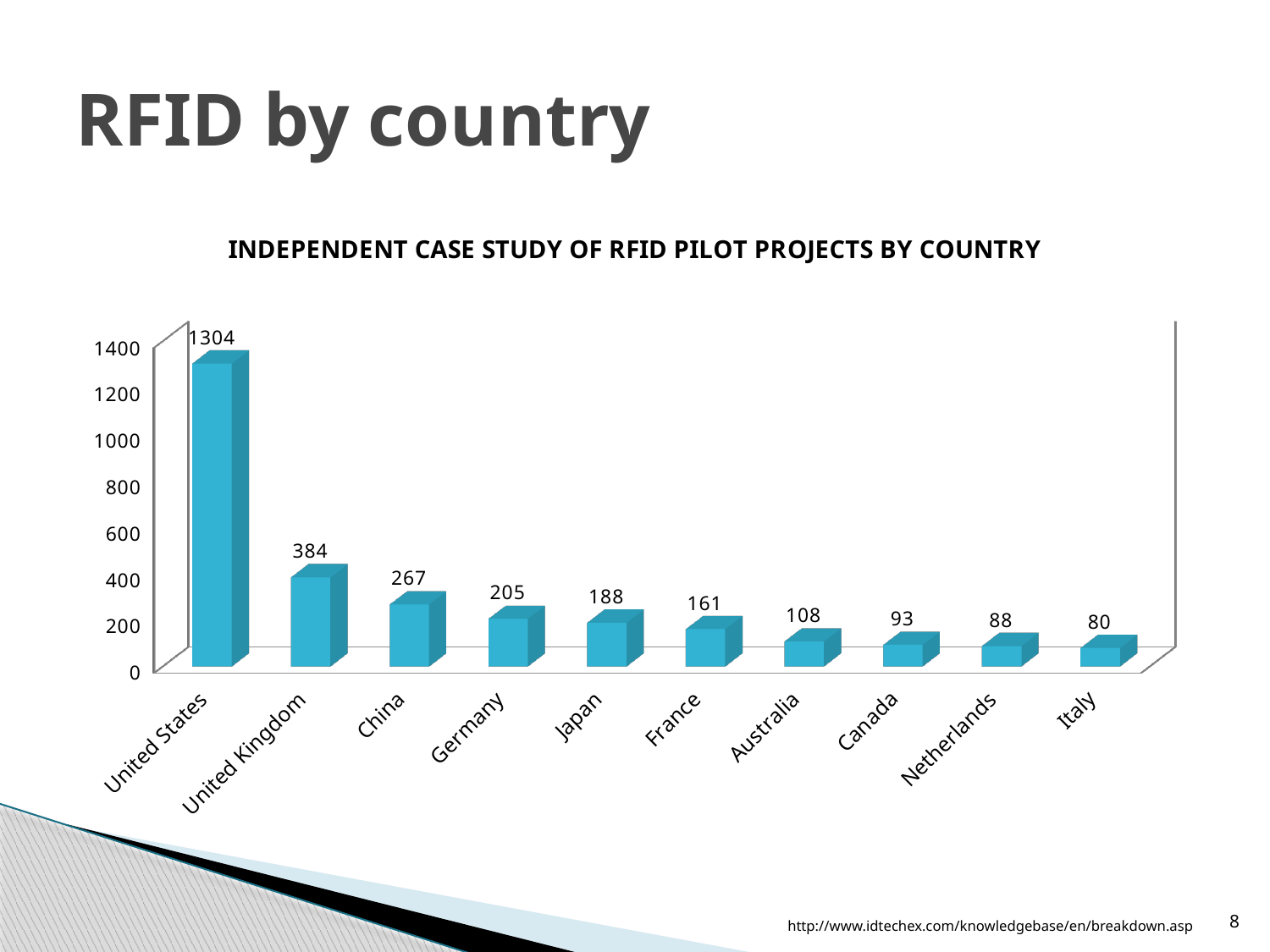
What is the value for the Netherlands? 88 What is the value for Germany? 205 What is the title of the chart? INDEPENDENT CASE STUDY OF RFID PILOT PROJECTS BY COUNTRY Which country has the lowest value? Italy Which has a larger value, Japan or France? Japan Do the values rise or fall from left to right along the x axis? fall What kind of chart is shown on the slide? bar chart Which country has the highest value? United States Is the value for the United Kingdom greater or less than 200? greater What is the difference between the values for the United Kingdom and China? 117 What is the value for the United States? 1304 How many countries are shown in the chart? 10